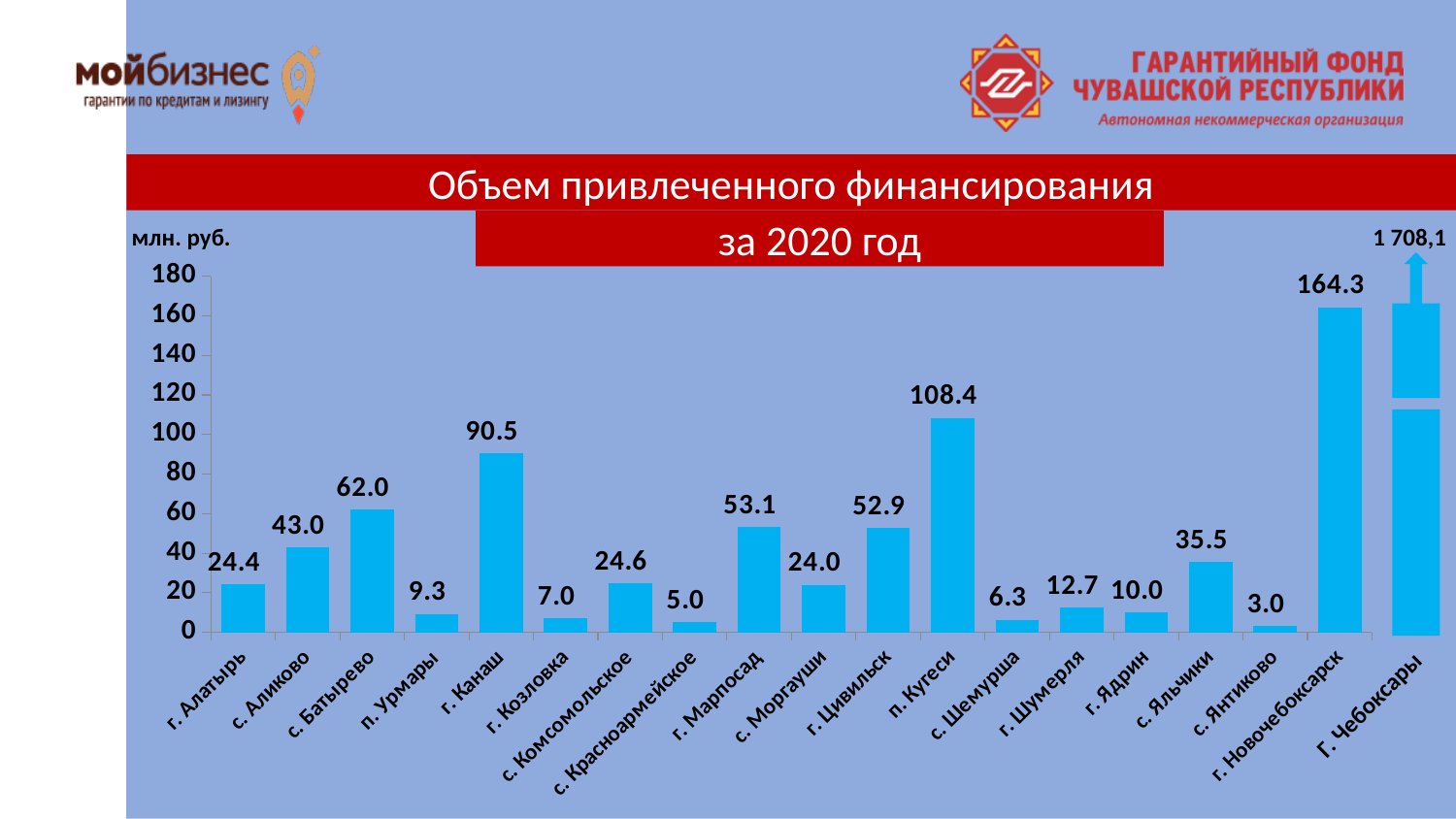
Which category has the lowest value? с. Янтиково Which is larger, the value for г. Канаш or the value for п. Кугеси? п. Кугеси What is the value for г. Канаш? 90.5 Is the value for г. Канаш greater or less than 80? greater Which category has the highest value? Г. Чебоксары What is the value for г. Новочебоксарск? 164.3 How many categories are shown on the x axis? 19 What unit is indicated for the values on the chart? млн. руб. What is the difference between the values for г. Новочебоксарск and п. Кугеси? 55.9 What is the value for Г. Чебоксары? 1 708,1 What is the value for п. Кугеси? 108.4 What type of chart is shown on the slide? bar chart